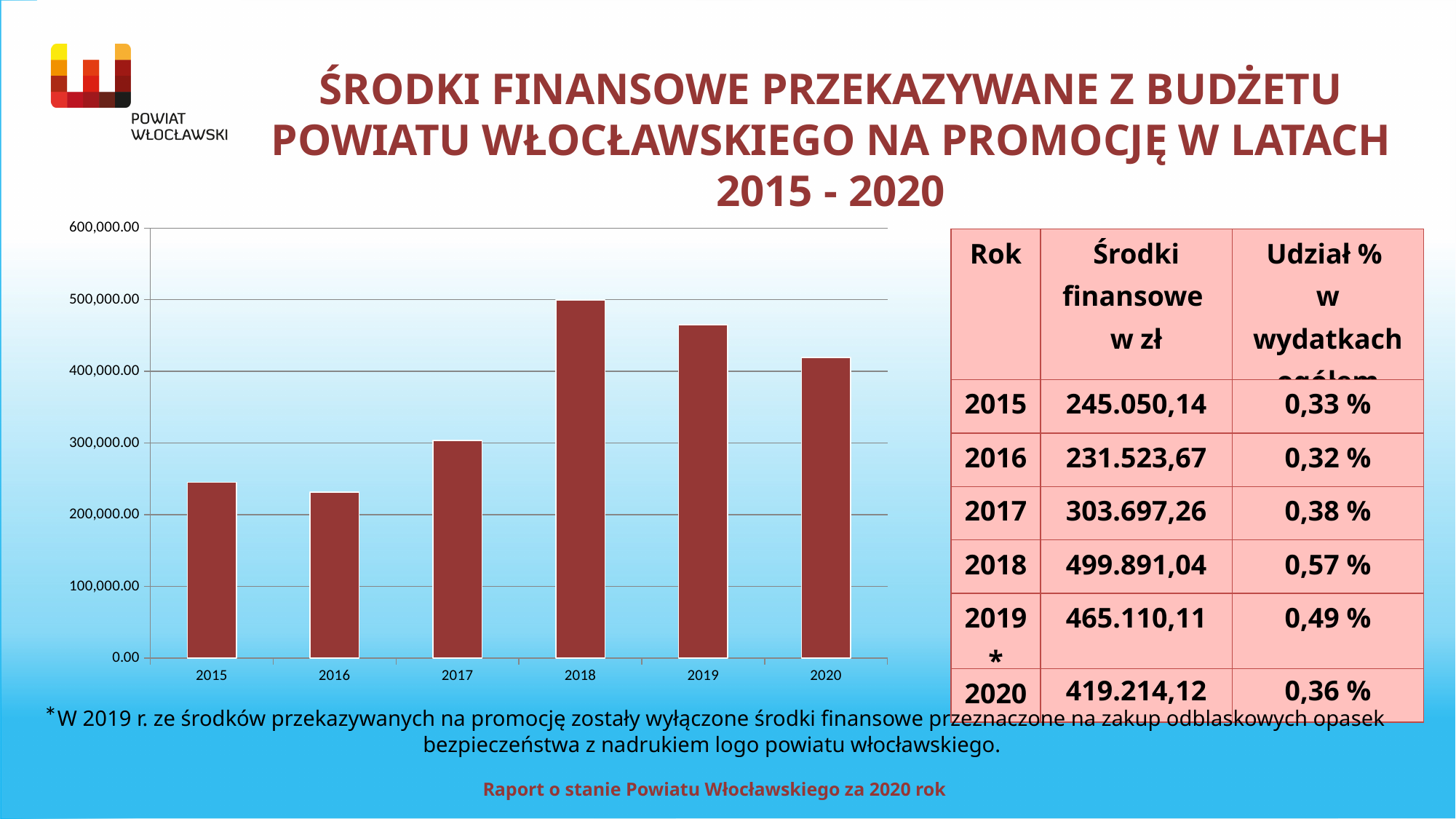
How many years are plotted on the chart? 6 According to the table on the slide, what was the share (Udział %) for 2019? 0,49 % Which year has the highest bar on the chart? 2018 Which bar is taller, 2015 or 2016? 2015 Is the value for 2016 greater or less than 300,000.00? less According to the table on the slide, what were the funds (Środki finansowe w zł) for 2018? 499.891,04 Is the value for 2018 greater or less than 400,000.00? greater Which bar is taller, 2017 or 2019? 2019 Is the value for 2020 greater or less than 400,000.00? greater What kind of chart is shown on the slide? bar chart Which year has the lowest bar on the chart? 2016 Do the bars rise or fall from 2018 to 2020? fall